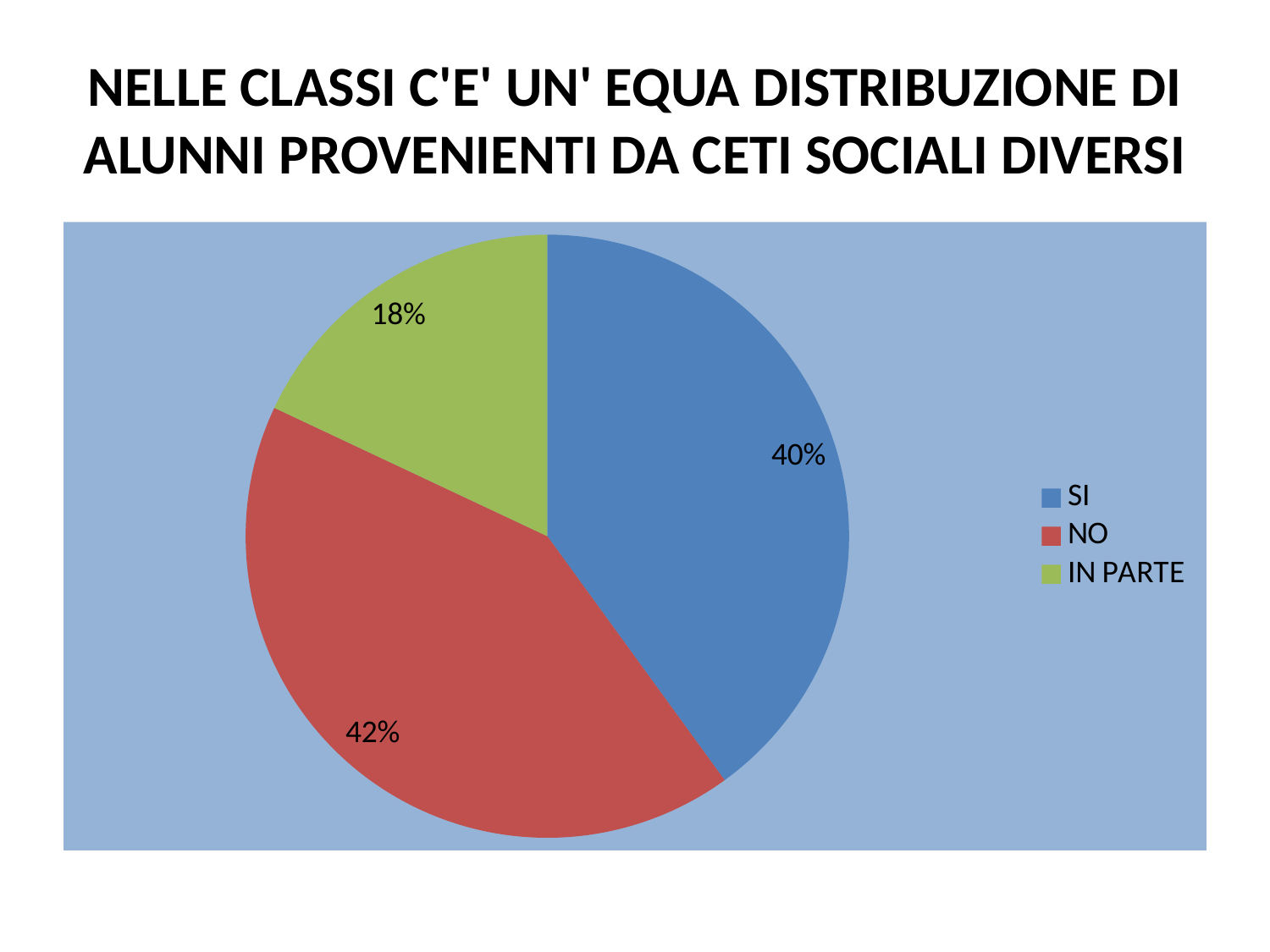
What kind of chart is shown on the slide? Pie chart Which is larger, the SI slice or the IN PARTE slice? SI What is the difference in percentage points between the SI slice and the IN PARTE slice? 22 Which category has the smallest slice of the pie? IN PARTE Which category has the largest slice of the pie? NO How many slices does the pie chart have? 3 What share of the pie does the IN PARTE slice represent? 18% Which colour represents the NO category in the pie chart? Red How many entries does the legend list? 3 What share of the pie does the NO slice represent? 42% What is the difference in percentage points between the NO slice and the IN PARTE slice? 24 What share of the pie does the SI slice represent? 40%